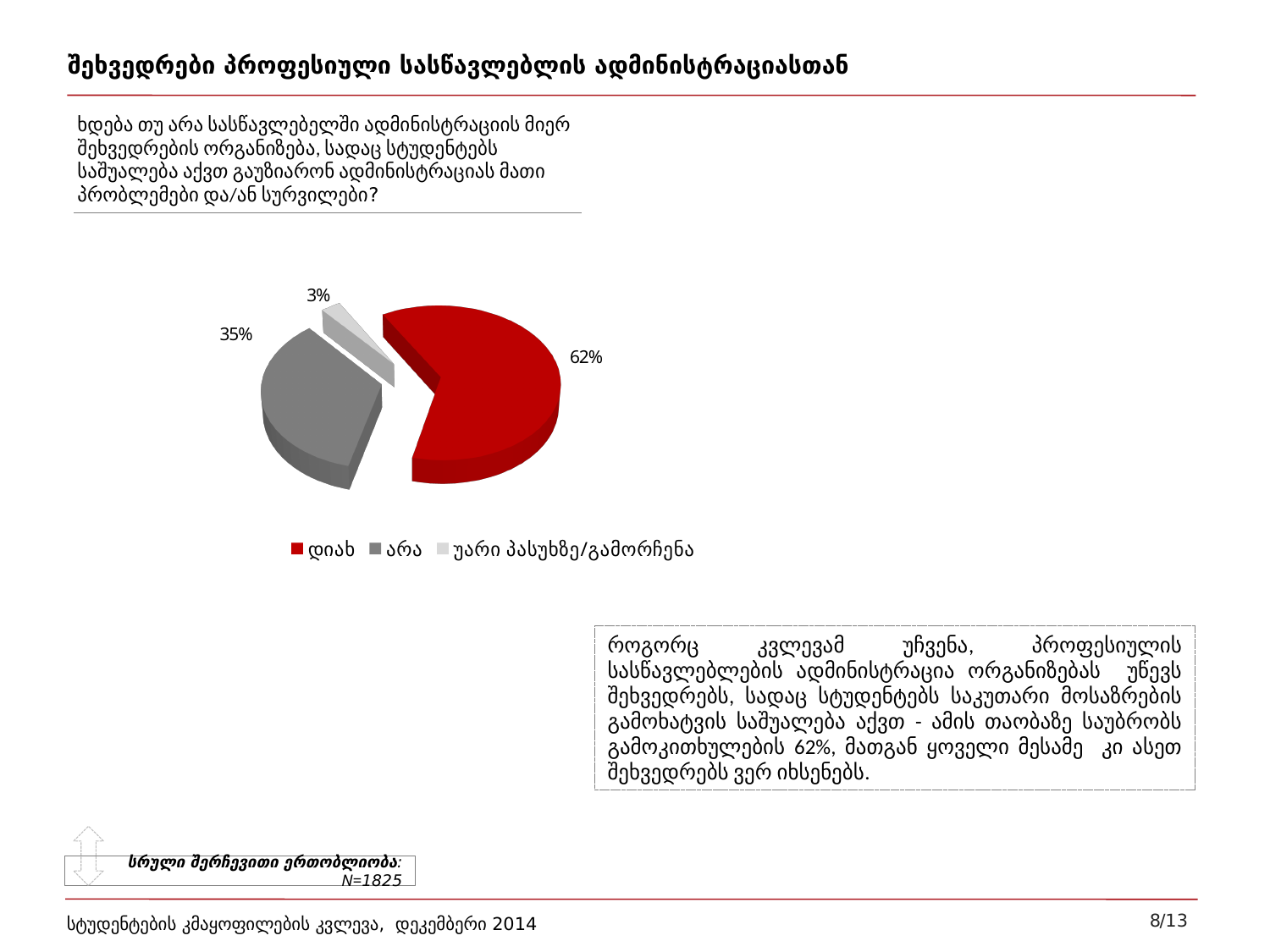
How many slices does the pie chart have? 3 Which category has the smallest slice of the pie? უარი პასუხზე/გამორჩენა What share of the pie does the "უარი პასუხზე/გამორჩენა" slice represent? 3% Which category has the largest slice of the pie? დიახ What share of the pie does the "დიახ" slice represent? 62% What colour is the "დიახ" slice in the pie chart? red What is the sample size (N) stated at the bottom of the slide? N=1825 Which is larger, the "არა" slice or the "უარი პასუხზე/გამორჩენა" slice? არა What share of the pie does the "არა" slice represent? 35% How many entries does the legend list? 3 What kind of chart is shown on the slide? pie chart What is the difference in percentage points between the "დიახ" and "არა" slices? 27